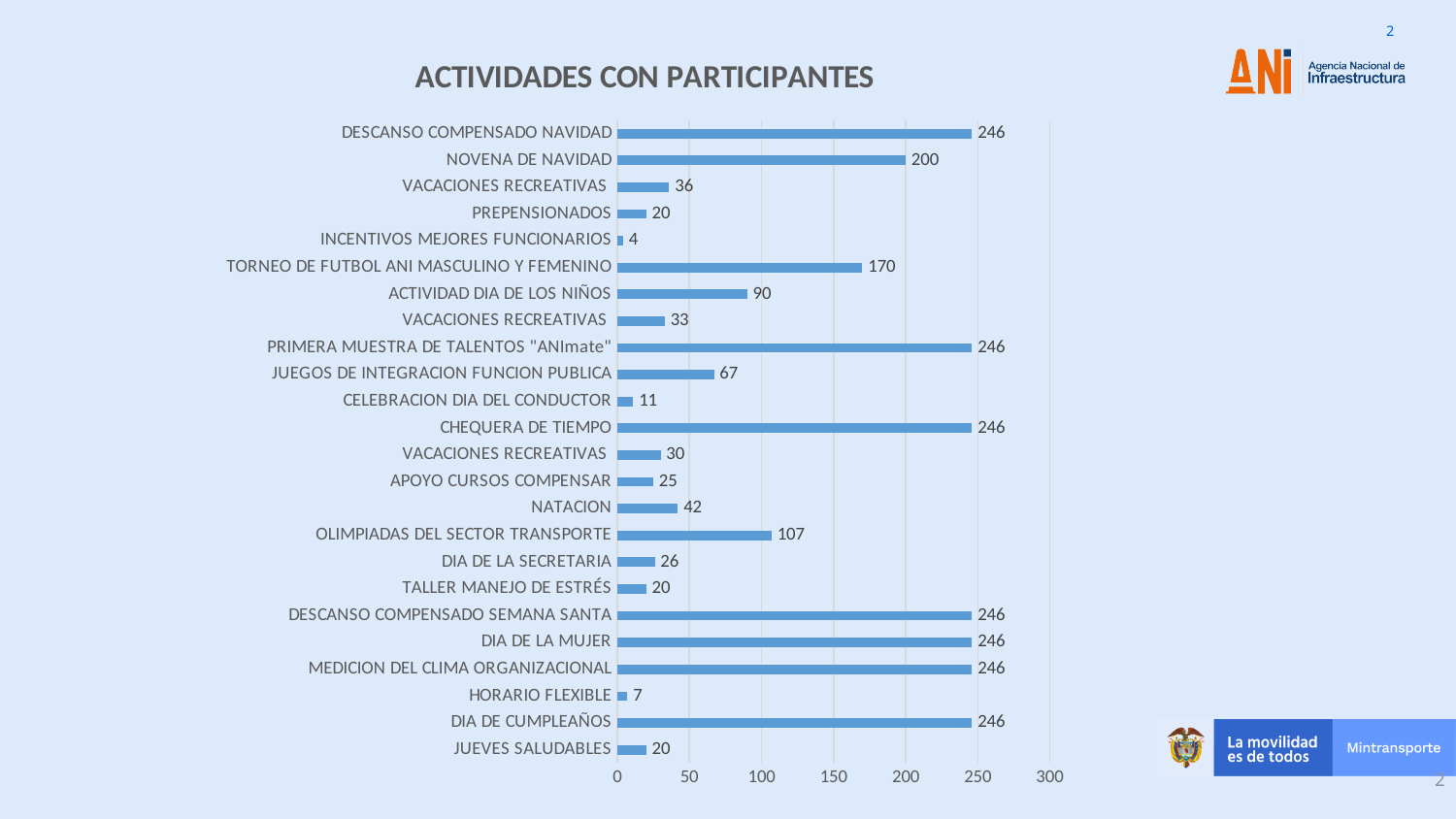
What is the title of the chart? ACTIVIDADES CON PARTICIPANTES What is the highest value shown on the chart? 246 Which activity has the lowest value? INCENTIVOS MEJORES FUNCIONARIOS What is the difference between the values for NOVENA DE NAVIDAD and ACTIVIDAD DIA DE LOS NIÑOS? 110 What is the value for NOVENA DE NAVIDAD? 200 What is the value for OLIMPIADAS DEL SECTOR TRANSPORTE? 107 What is the value for HORARIO FLEXIBLE? 7 How many activities (bars) are shown on the chart? 24 Is the value for JUEGOS DE INTEGRACION FUNCION PUBLICA greater or less than 100? less What kind of chart is shown on the slide? bar chart What is the value for TORNEO DE FUTBOL ANI MASCULINO Y FEMENINO? 170 Which is larger, the value for NATACION or the value for DIA DE LA SECRETARIA? NATACION